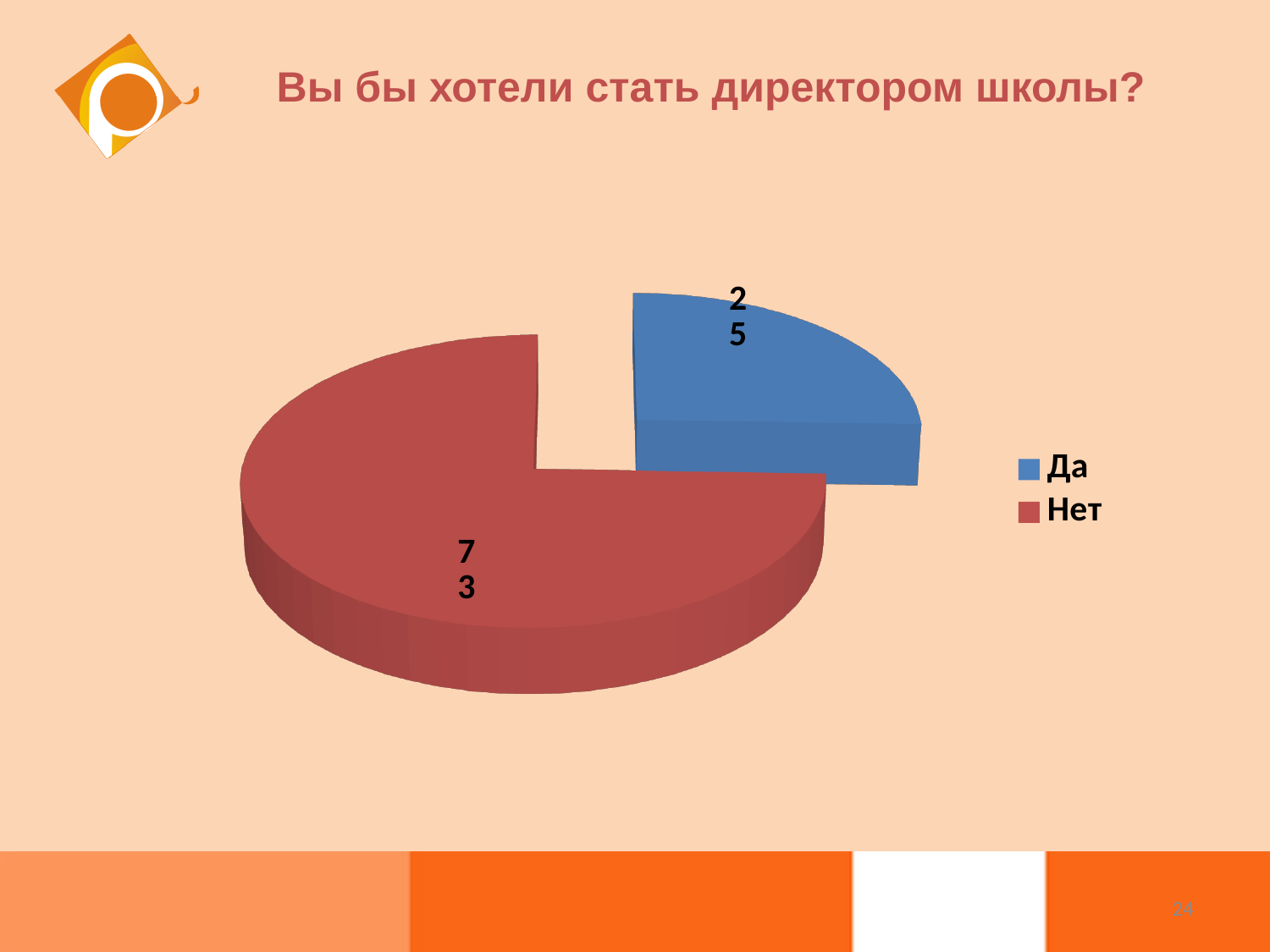
What is the difference between the Нет value and the Да value? 48 How many slices does the pie chart have? 2 What is the sum of the two values shown on the pie chart? 98 What is the title of the slide? Вы бы хотели стать директором школы? What is the value shown for the Да slice? 25 What kind of chart is shown on the slide? Pie chart Which slice is the largest? Нет Which slice is the smallest? Да How many entries does the legend list? 2 What is the value shown for the Нет slice? 73 Which is larger, the value for Да or the value for Нет? Нет What colour is the Да slice? Blue